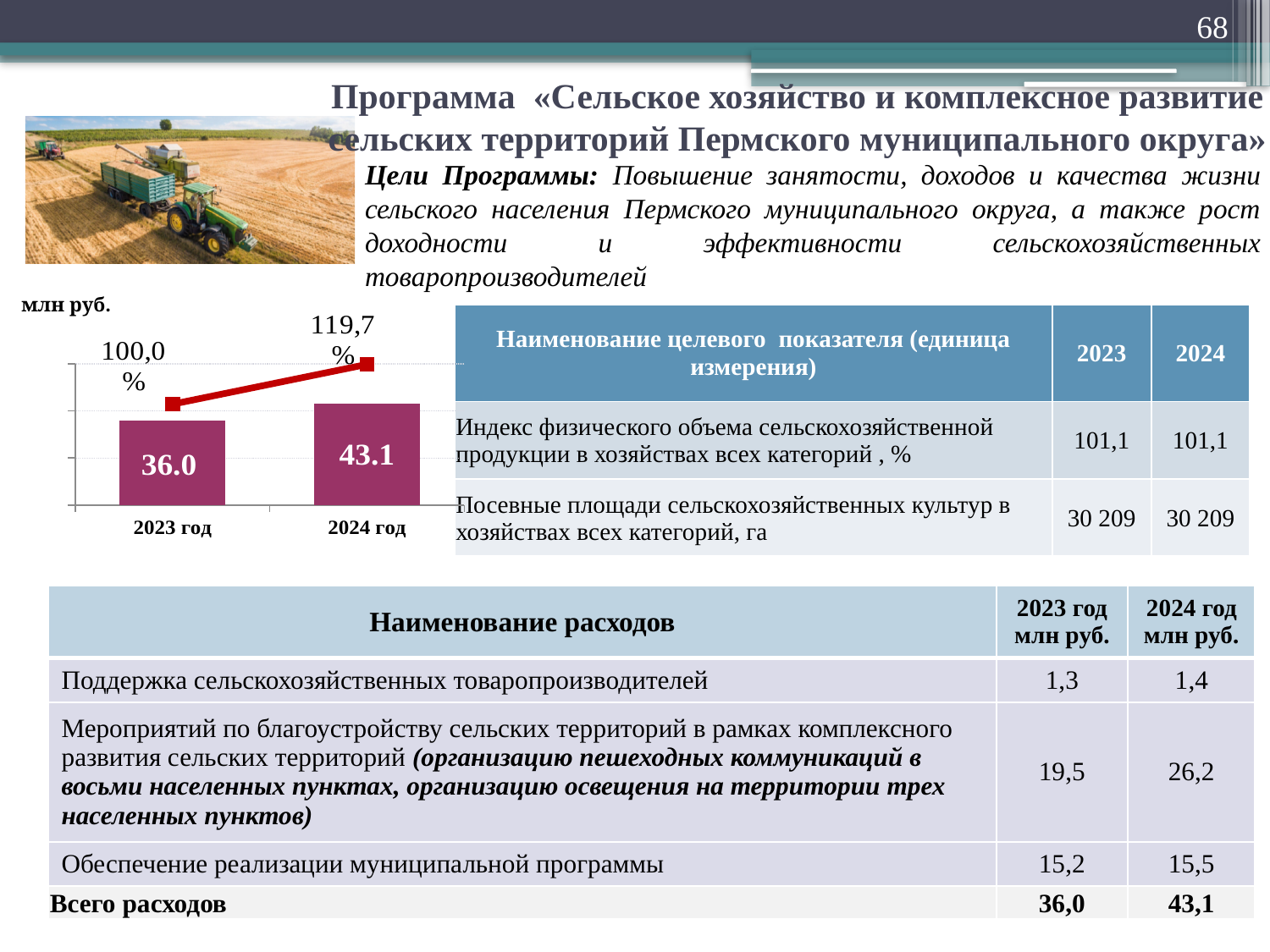
What kind of chart is shown on the slide? bar chart with a line What unit is indicated above the chart? млн руб. What is the value of the bar for 2024 год? 43.1 What is the value of the bar for 2023 год? 36.0 What percentage is shown on the line for 2023 год? 100,0 % Do the bar values rise or fall from 2023 год to 2024 год? rise How many years (categories) are shown on the chart's x axis? 2 Which year has the higher bar value? 2024 год Is the bar value for 2024 год larger or smaller than the bar value for 2023 год? larger What percentage is shown on the line for 2024 год? 119,7 % Which year has the lower bar value? 2023 год What is the difference between the bar values for 2024 год and 2023 год? 7.1